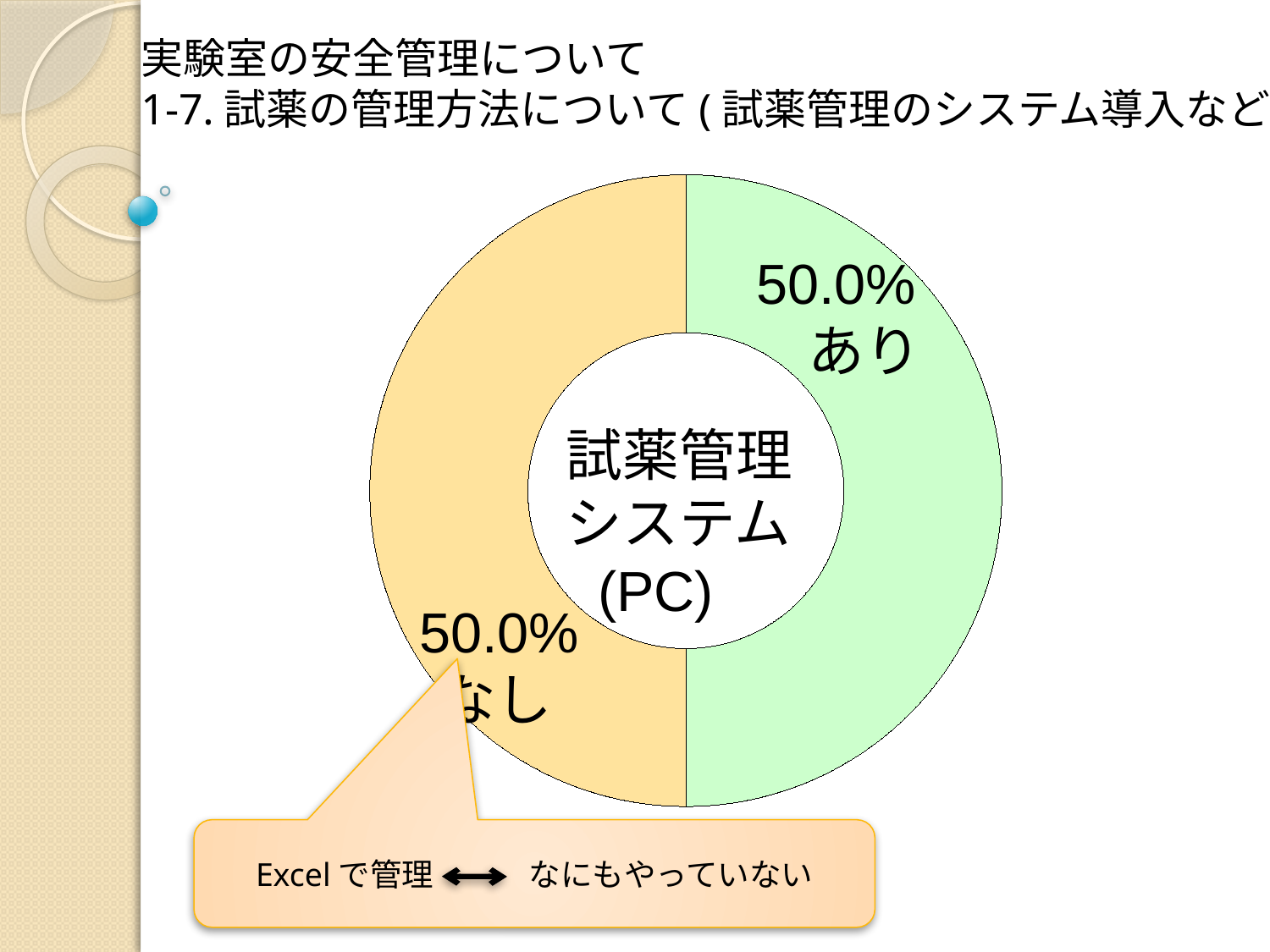
What percentage of the doughnut chart is labelled なし? 50.0% What text is written in the centre of the doughnut chart? 試薬管理システム(PC) How many slices does the doughnut chart have? 2 What kind of chart is shown on the slide? Doughnut (pie) chart What is the difference between the あり and なし percentages? 0.0% What share of the chart does the なし slice take up? 50.0% What percentage of the doughnut chart is labelled あり? 50.0% What colour is the あり slice of the doughnut chart? Green